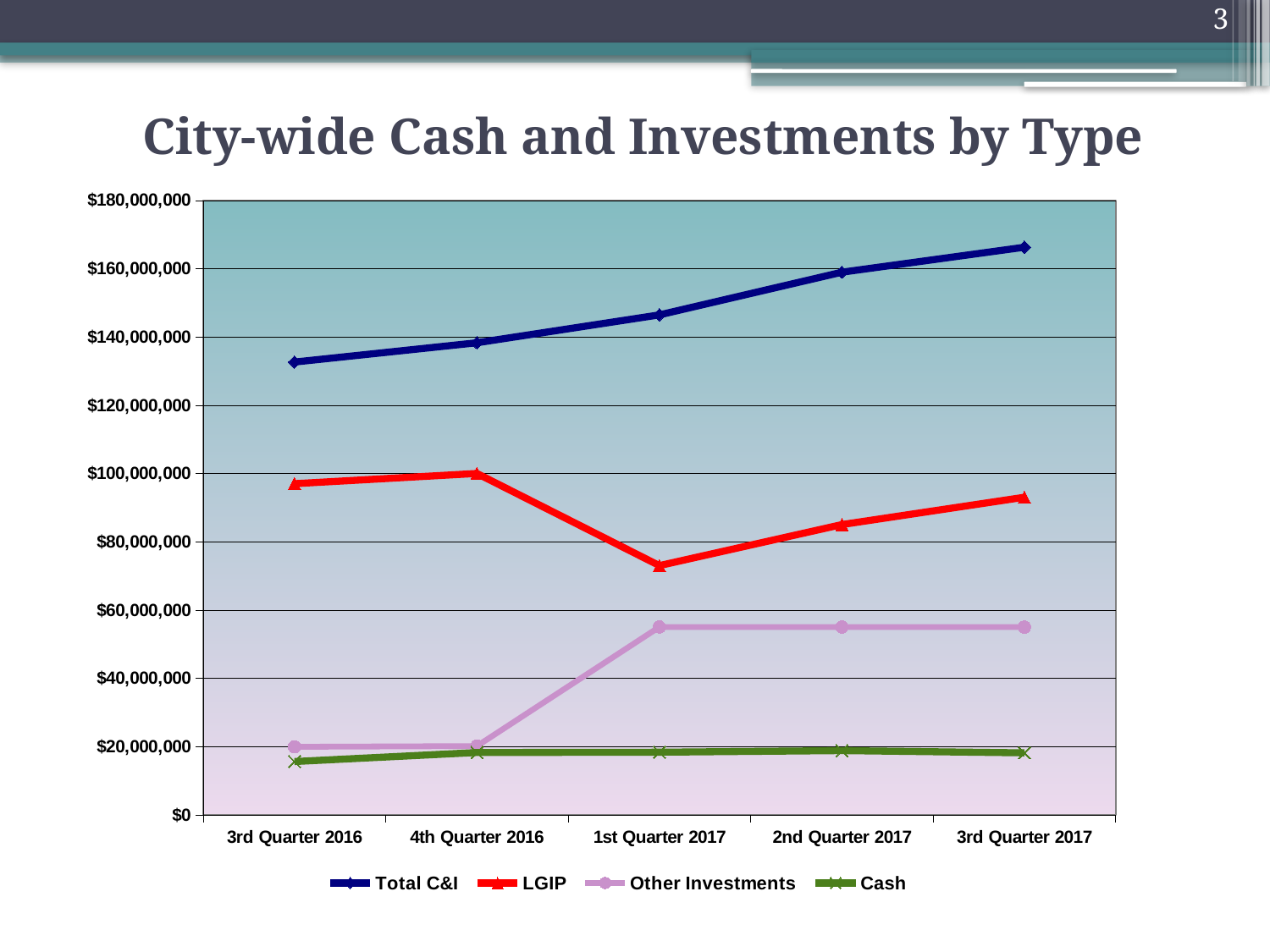
How many series does the legend list? 4 In which quarter is LGIP lowest? 1st Quarter 2017 Is the value for Total C&I in 3rd Quarter 2017 greater or less than $160,000,000? greater Is the value for LGIP in 1st Quarter 2017 greater or less than $80,000,000? less Is the value for Other Investments in 1st Quarter 2017 greater or less than $40,000,000? greater What kind of chart is shown on the slide? line chart How many quarters are plotted along the x axis? 5 In 1st Quarter 2017, which is larger: LGIP or Other Investments? LGIP In which quarter is Total C&I highest? 3rd Quarter 2017 What is the title of the chart? City-wide Cash and Investments by Type Does the Total C&I series rise or fall from 3rd Quarter 2016 to 3rd Quarter 2017? rise